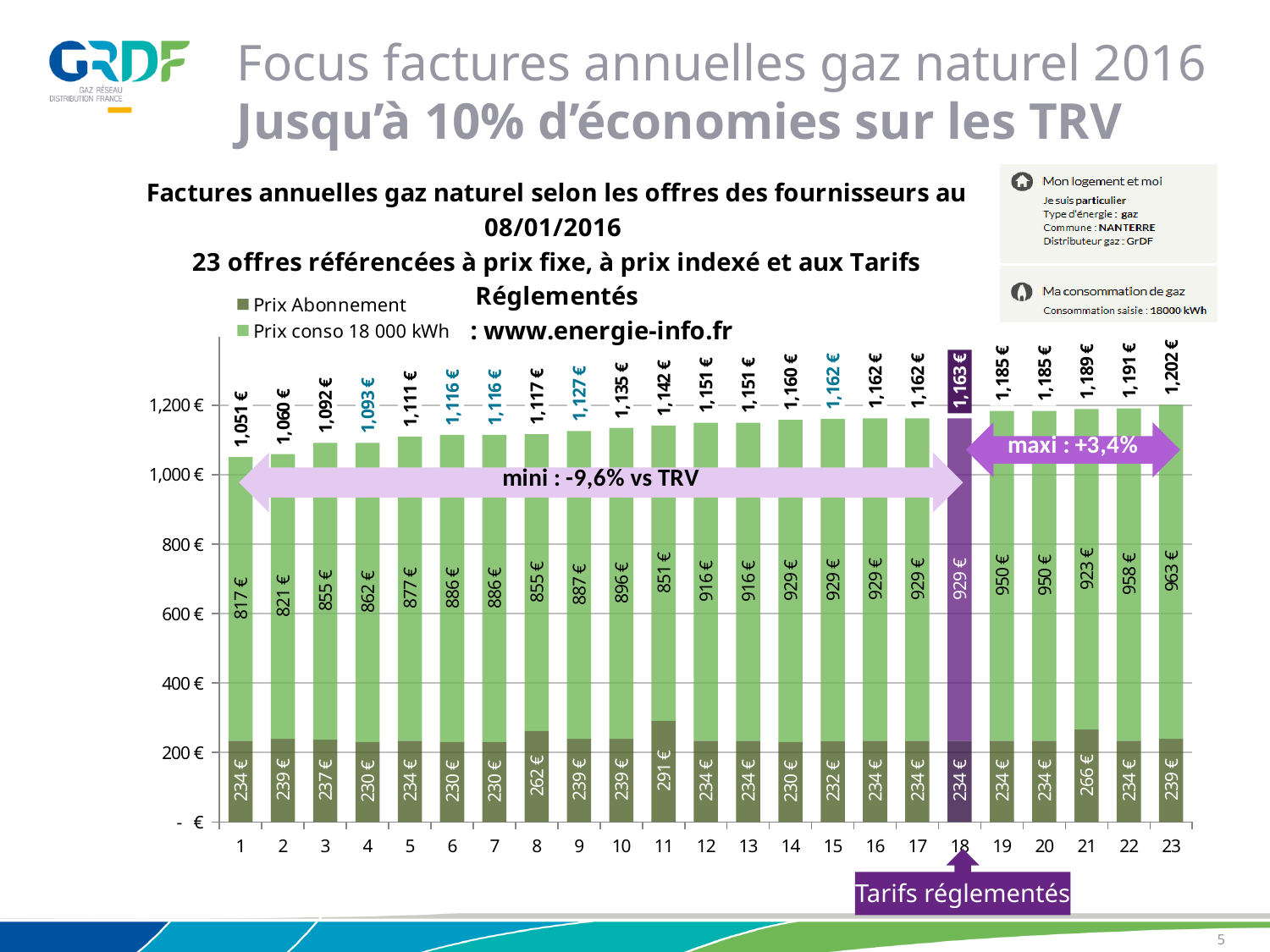
Do the total annual bills rise or fall from offer 1 to offer 23? Rise Which offer has the lowest total annual bill? 1 Which has the larger Prix conso 18 000 kWh value, offer 8 or offer 9? Offer 9 How many series does the chart legend list? 2 What is the Prix Abonnement value for offer 11? 291 € How many offers (bars) are plotted on the chart? 23 Which offer number is highlighted in purple as the Tarifs réglementés? 18 What kind of chart is shown on the slide? Stacked bar chart What is the total annual bill shown above the bar for offer 18? 1,163 € Which offer has the highest total annual bill? 23 What is the Prix conso 18 000 kWh value for offer 1? 817 € What is the difference between the total for offer 23 and the total for offer 1? 151 €